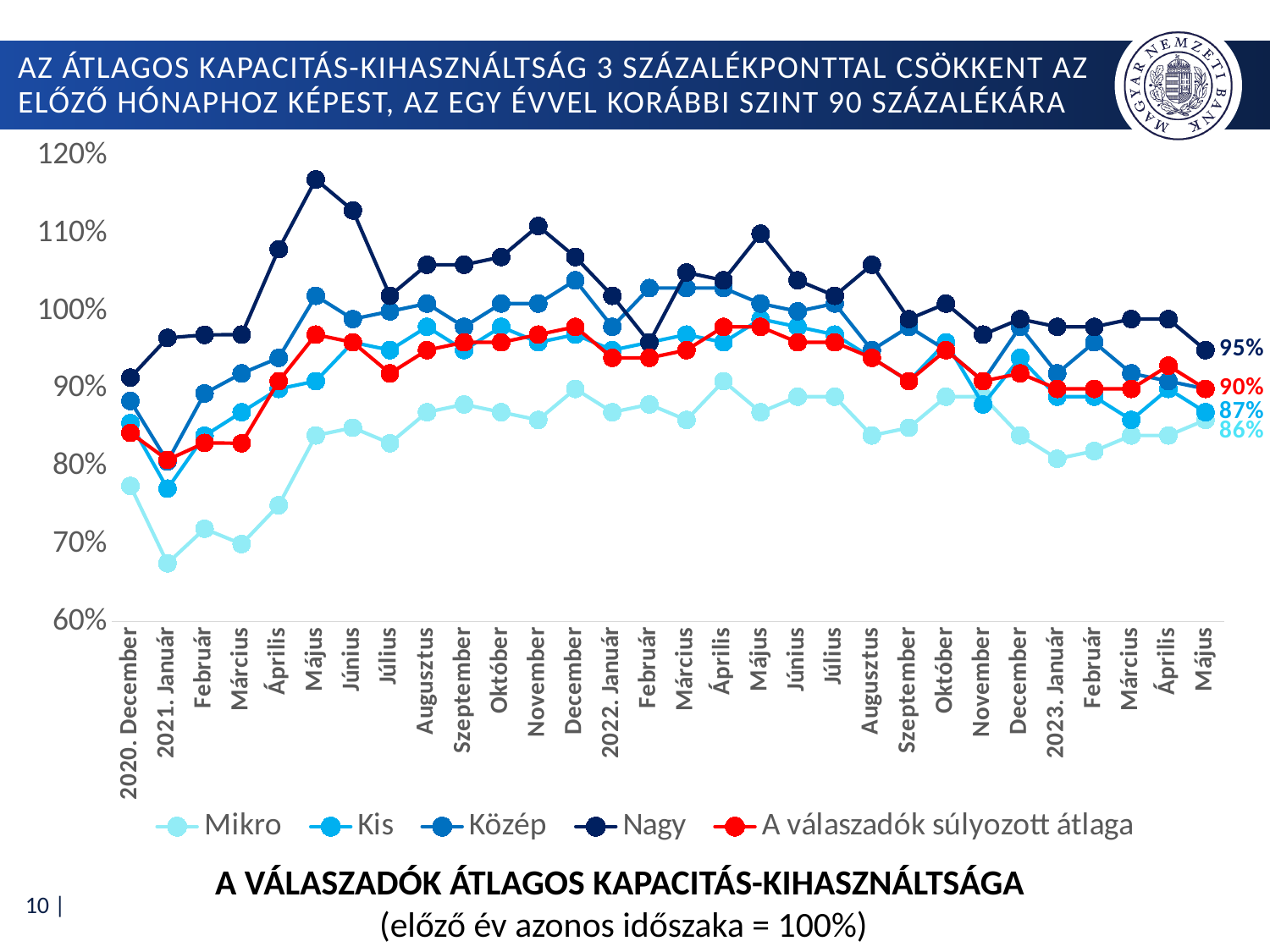
What is the value for Mikro in 2023 Május? 86% What is the value for Nagy in 2023 Május? 95% In which month does the Mikro series reach its lowest value? 2021. Január Is the value for Nagy in 2021 Május greater or less than 110%? greater Is the value for Mikro in 2021 Január greater or less than 70%? less What is the value for A válaszadók súlyozott átlaga in 2023 Május? 90% In which month does the Nagy series reach its highest value? 2021. Május How many series does the legend list? 5 How many months (data points) are shown along the x axis? 30 What is the difference between the Nagy and Mikro values in 2023 Május? 9 percentage points What type of chart is shown on the slide? line chart Which series is shown in red in the legend? A válaszadók súlyozott átlaga